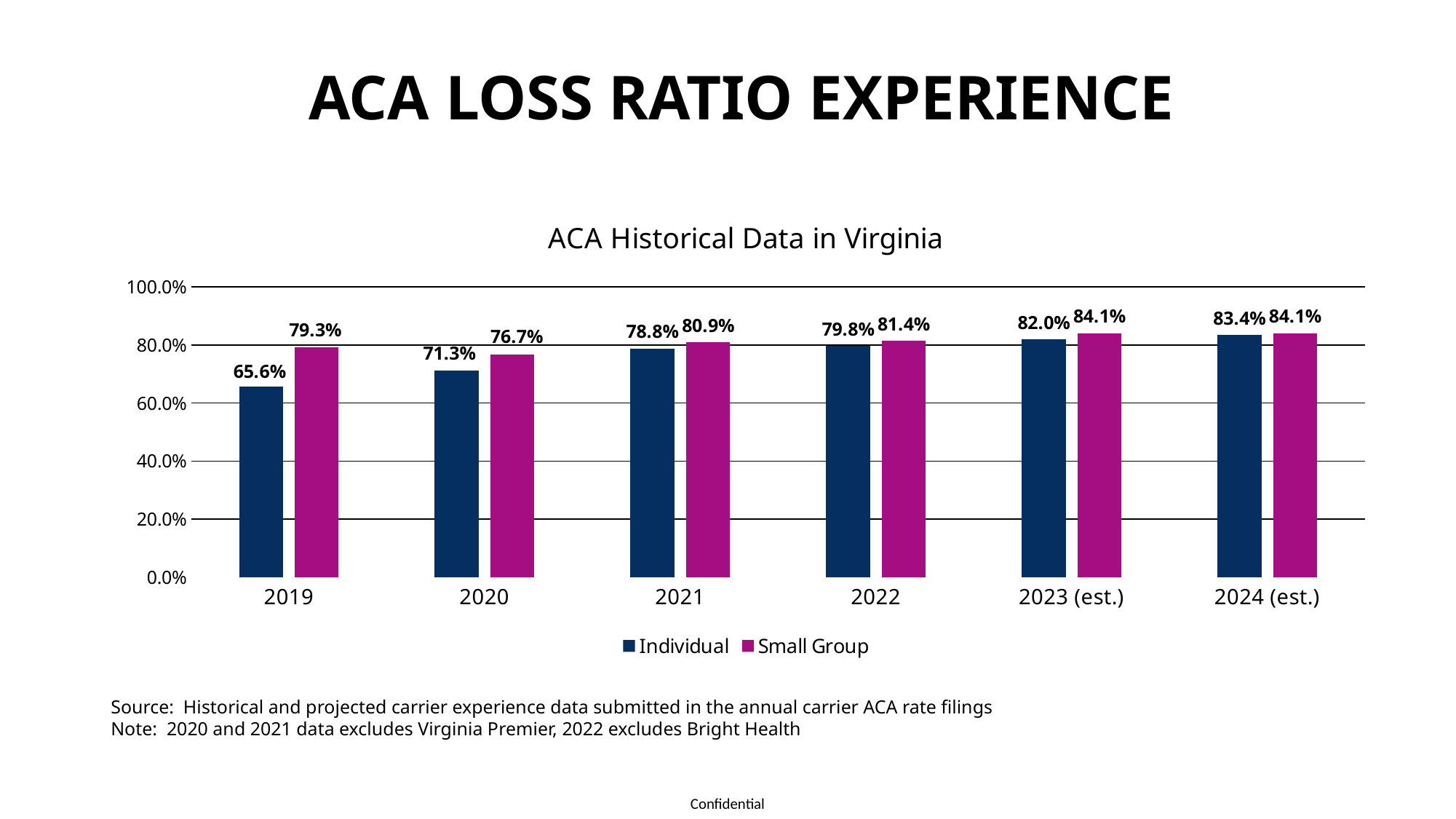
What is the Small Group loss ratio for 2021? 80.9% What is the Individual loss ratio for 2019? 65.6% What is the difference between the Small Group and Individual loss ratios in 2019? 13.7% Which year has the lowest Small Group loss ratio? 2020 Which is larger in 2022, the Individual or the Small Group loss ratio? Small Group Does the Individual loss ratio rise or fall from 2019 to 2024 (est.)? rise What kind of chart is shown? bar chart How many series does the legend list? 2 Is the Individual loss ratio for 2020 greater or less than 80.0%? less What is the Individual loss ratio for 2024 (est.)? 83.4% Which year has the lowest Individual loss ratio? 2019 How many years are shown on the x axis? 6